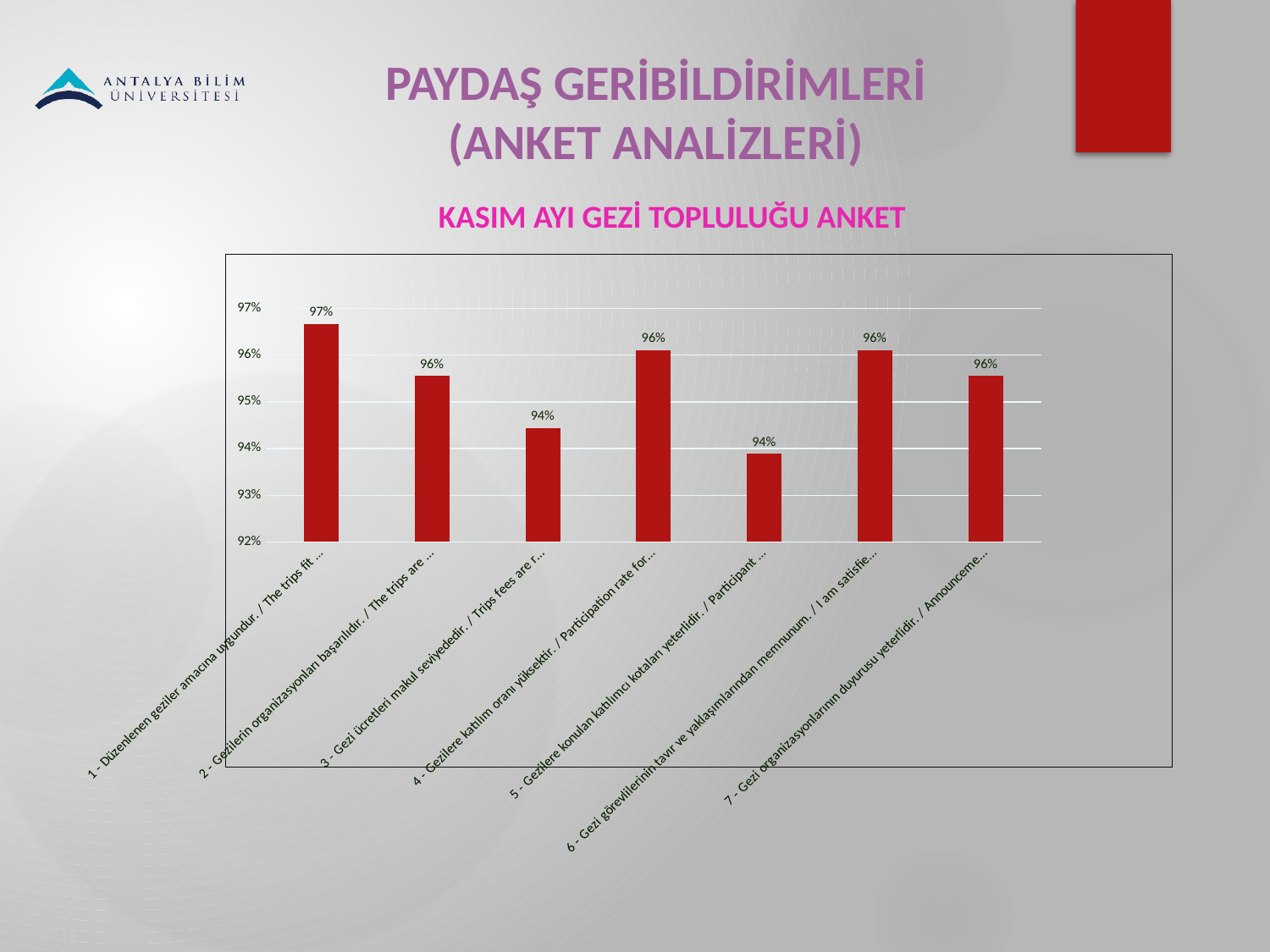
Which is larger, the value for item 1 or the value for item 2? Item 1 Which item has the highest value in the chart? 1 - Düzenlenen geziler amacına uygundur. / The trips fit ... Is the value for item 2 (Gezilerin organizasyonları başarılıdır) greater or less than 95%? greater Which item has the lowest bar in the chart? 5 - Gezilere konulan katılımcı kotaları yeterlidir. / Participant ... What is the value shown for item 1 (Düzenlenen geziler amacına uygundur / The trips fit ...)? 97% How many items (bars) are shown in the chart? 7 What is the value shown for item 3 (Gezi ücretleri makul seviyededir / Trips fees are ...)? 94% What is the value shown for item 7 (Gezi organizasyonlarının duyurusu yeterlidir / Announcement ...)? 96% What kind of chart is shown on the slide? Bar chart What is the title of the chart on the slide? KASIM AYI GEZİ TOPLULUĞU ANKET What is the difference between the value for item 1 and the value for item 3? 3% What is the value shown for item 6 (Gezi görevlilerinin tavır ve yaklaşımlarından memnunum / I am satisfied ...)? 96%